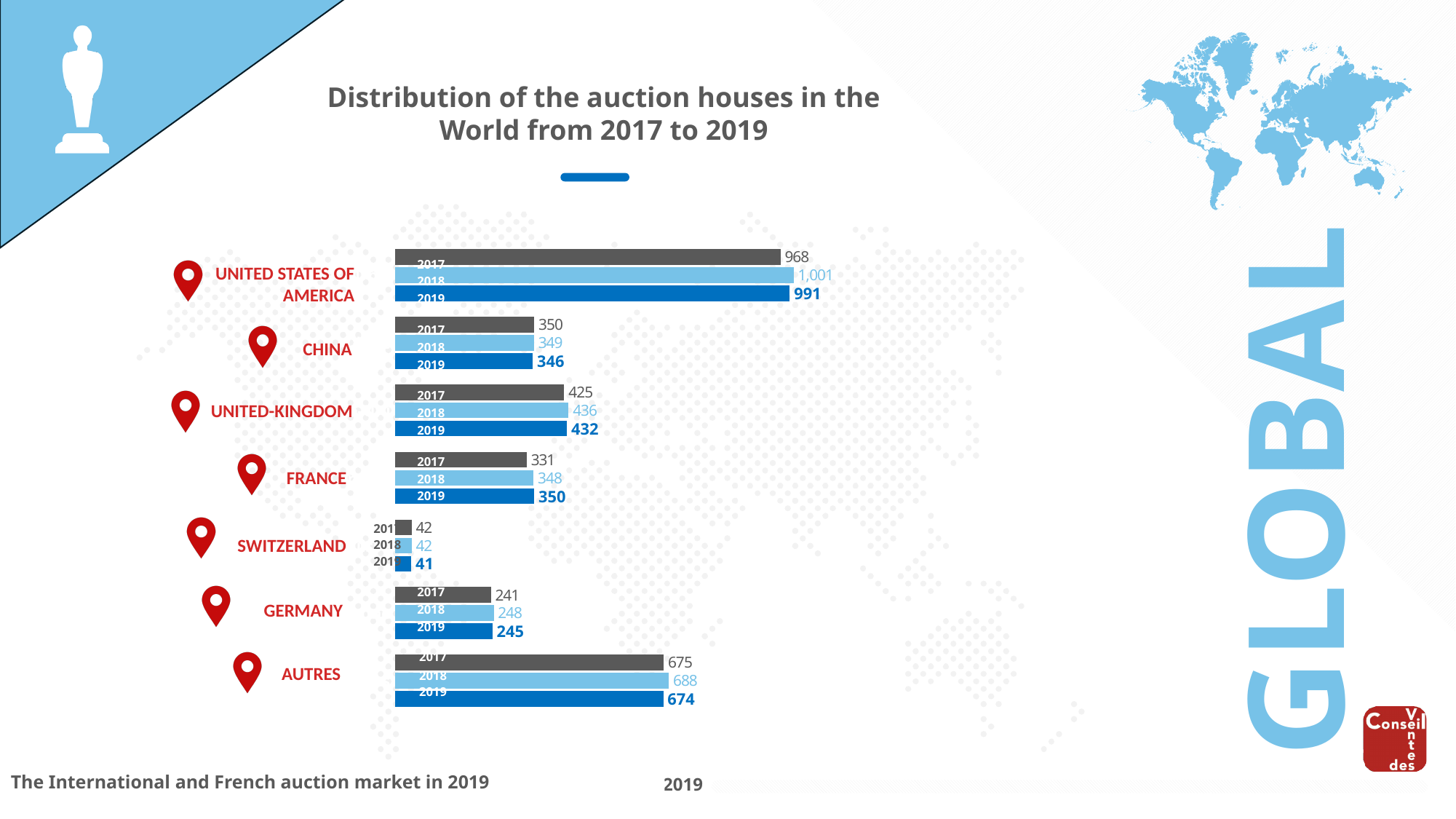
Did the value for Switzerland rise or fall from 2017 to 2019? Fall What was the number of auction houses in the United States of America in 2018? 1,001 How many countries or groups are shown on the chart? 7 What is the title of the chart? Distribution of the auction houses in the World from 2017 to 2019 What kind of chart is shown on the slide? Bar chart Which country or group had the highest value in 2019? United States of America What was the value for France in 2019? 350 Which country had the lowest value in 2017? Switzerland How many years (series) are shown for each country? 3 What was the value for Germany in 2017? 241 Which is larger: China's 2019 value or France's 2019 value? France's 2019 value What is the difference between the United Kingdom's 2018 and 2017 values? 11